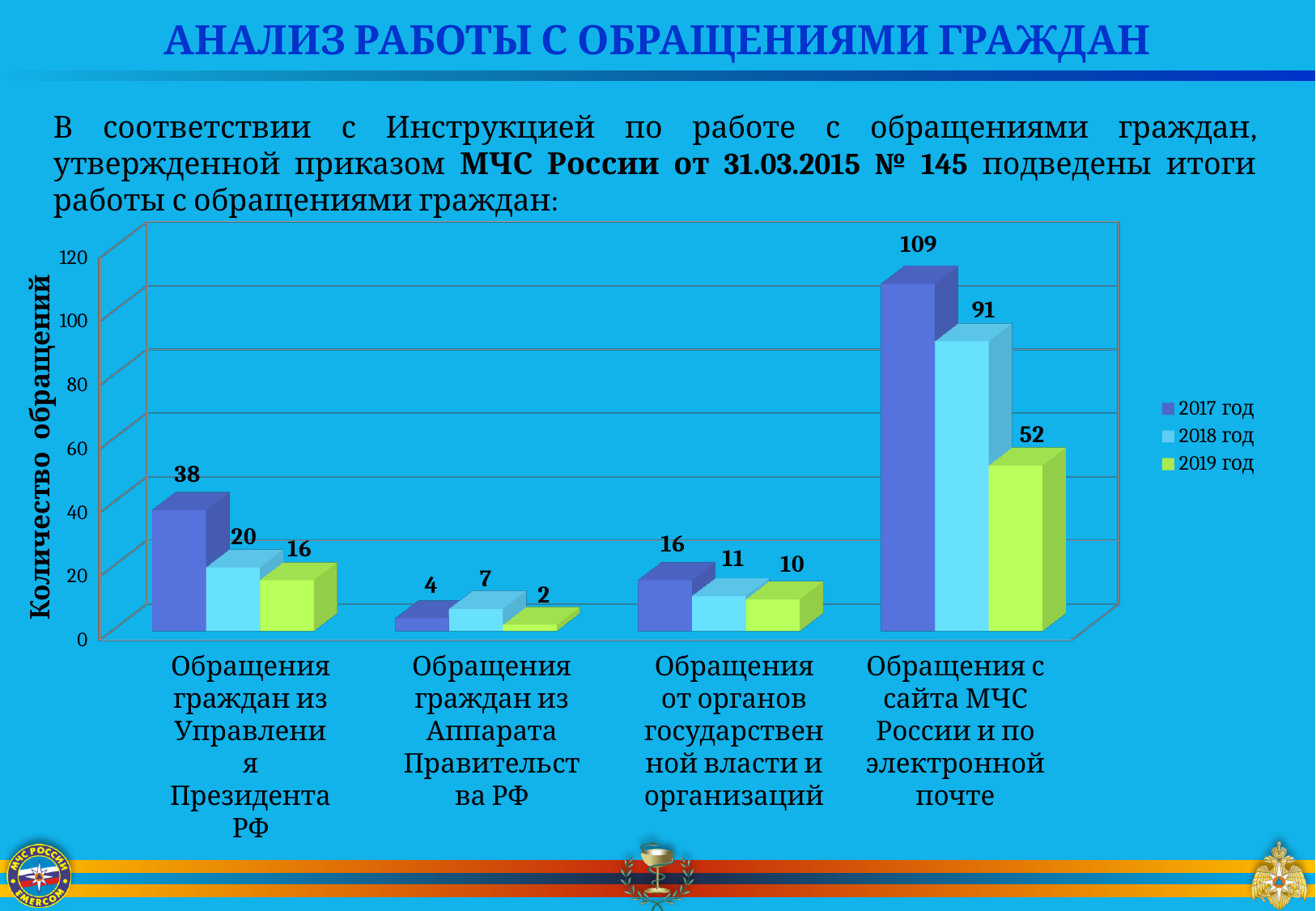
Какая категория обращений имеет наименьшее значение в 2019 году? Обращения граждан из Аппарата Правительства РФ Сколько обращений граждан из Аппарата Правительства РФ было в 2018 году? 7 Какой тип диаграммы представлен на слайде? Столбчатая (bar chart) Какова разница между числом обращений граждан из Управления Президента РФ в 2017 и 2018 годах? 18 Сколько обращений от органов государственной власти и организаций было в 2019 году? 10 Сколько категорий обращений показано на диаграмме? 4 Какая категория обращений имеет наибольшее значение в 2018 году? Обращения с сайта МЧС России и по электронной почте На сколько уменьшилось число обращений с сайта МЧС России и по электронной почте с 2017 по 2019 год? 57 Что больше: обращения граждан из Аппарата Правительства РФ в 2018 году или в 2017 году? В 2018 году (7) Что больше: число обращений граждан из Управления Президента РФ в 2019 году или число обращений от органов государственной власти и организаций в 2017 году? Они равны (16) Сколько рядов данных указано в легенде диаграммы? 3 Сколько обращений с сайта МЧС России и по электронной почте было в 2017 году? 109